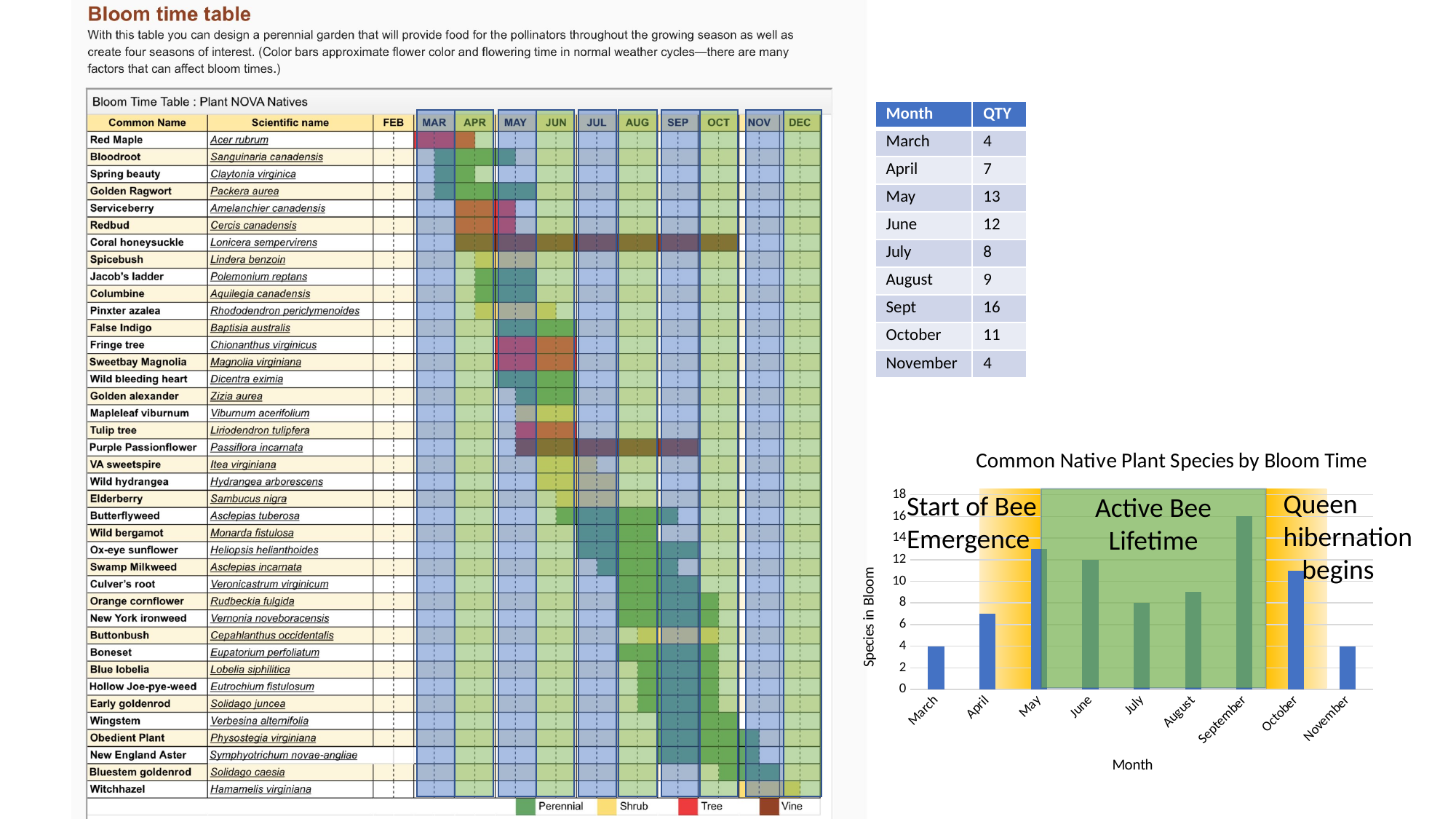
In the "Common Native Plant Species by Bloom Time" chart, which has more species in bloom, June or July? June In the "Common Native Plant Species by Bloom Time" chart, how many species are in bloom in September? 16 What is the y-axis title of the "Common Native Plant Species by Bloom Time" chart? Species in Bloom In the "Common Native Plant Species by Bloom Time" chart, which month has the highest number of species in bloom? September What is the x-axis title of the "Common Native Plant Species by Bloom Time" chart? Month In the "Common Native Plant Species by Bloom Time" chart, do the values rise or fall from May to July? fall In the "Common Native Plant Species by Bloom Time" chart, how many species are in bloom in March? 4 In the "Common Native Plant Species by Bloom Time" chart, what is the difference between the September and March values? 12 What type of chart is "Common Native Plant Species by Bloom Time"? bar chart In the "Common Native Plant Species by Bloom Time" chart, how many species are in bloom in May? 13 In the "Common Native Plant Species by Bloom Time" chart, is the value for May greater or less than 10? greater How many months are shown on the x axis of the "Common Native Plant Species by Bloom Time" chart? 9